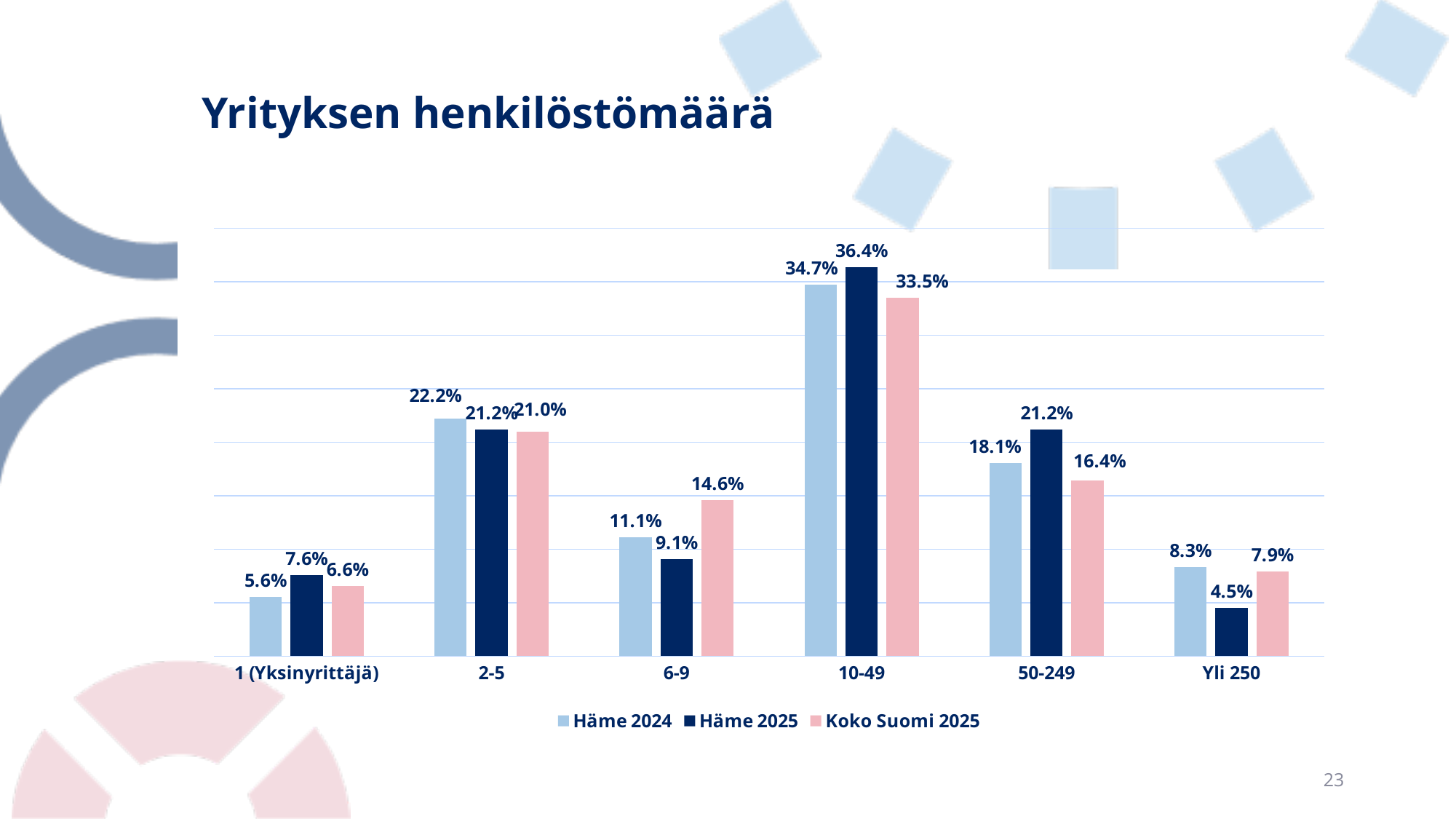
What is the difference between the Häme 2024 and Häme 2025 values for the 2-5 category? 1.0% What is the Häme 2025 value for the 10-49 category? 36.4% What is the Häme 2024 value for the 50-249 category? 18.1% What is the Koko Suomi 2025 value for the 6-9 category? 14.6% What kind of chart is shown on the slide? Bar chart Which is larger for the 6-9 category: Häme 2024 or Häme 2025? Häme 2024 How many categories are shown on the x axis? 6 What is the title of the chart? Yrityksen henkilöstömäärä Which category has the highest Häme 2025 value? 10-49 Which category has the lowest Häme 2025 value? Yli 250 What is the difference between the Häme 2025 and Koko Suomi 2025 values for the 50-249 category? 4.8% How many series does the legend list? 3